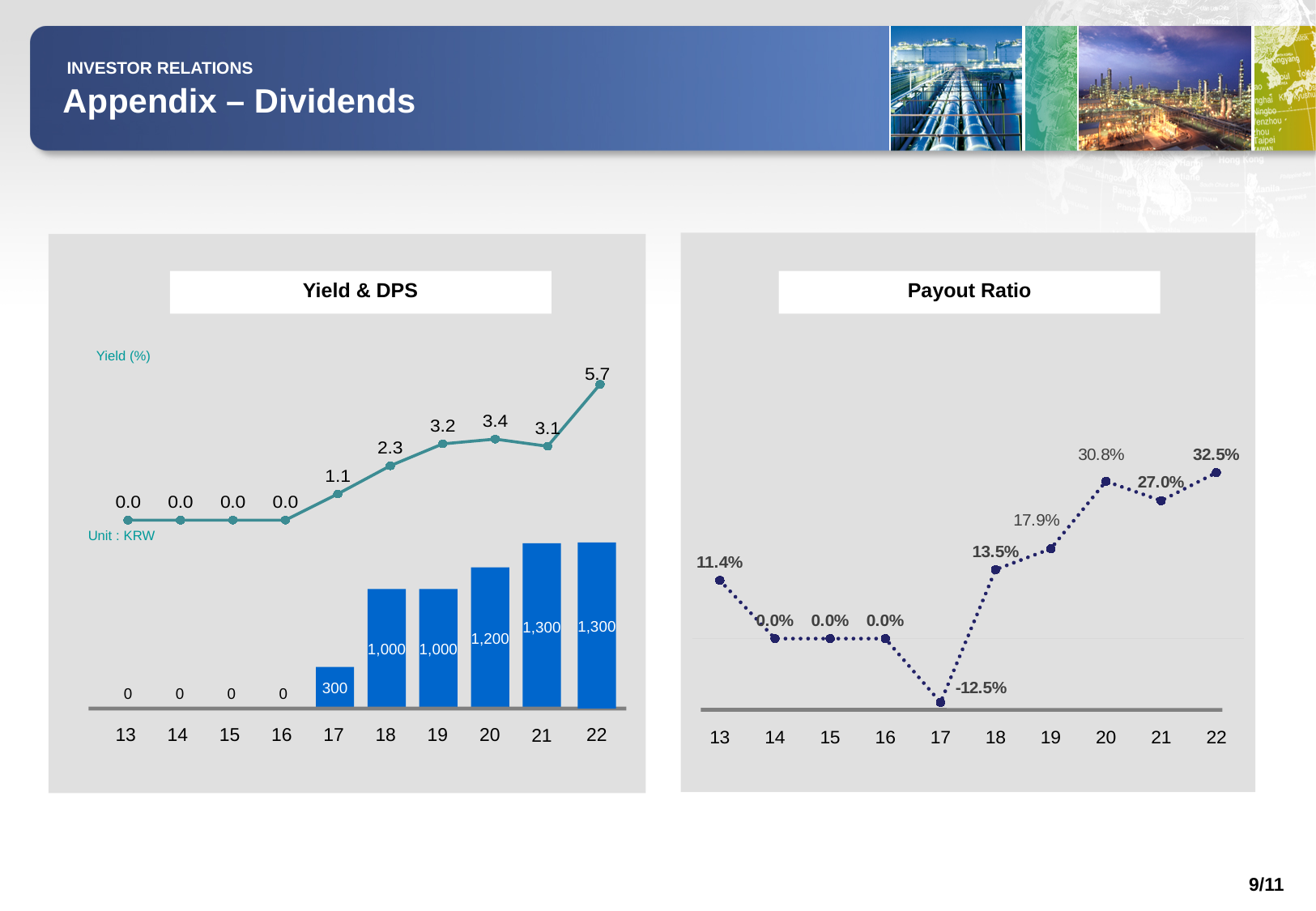
In the Yield & DPS chart, which year has the highest yield? 22 In the Yield & DPS chart, what is the yield (%) for 22? 5.7 In the Payout Ratio chart, what is the payout ratio for 20? 30.8% In the Payout Ratio chart, which year has the lowest payout ratio? 17 In the Yield & DPS chart, what is the difference in DPS between 21 and 17? 1,000 In the Yield & DPS chart, what is the DPS for 20? 1,200 In the Yield & DPS chart, what unit is given for DPS? KRW In the Payout Ratio chart, does the payout ratio rise or fall from 17 to 20? rise In the Payout Ratio chart, what is the difference between the payout ratio for 22 and for 21? 5.5% In the Payout Ratio chart, what kind of chart is used? line chart In the Yield & DPS chart, is the yield for 19 or 21 larger? 19 In the Yield & DPS chart, how many years are shown on the x axis? 10